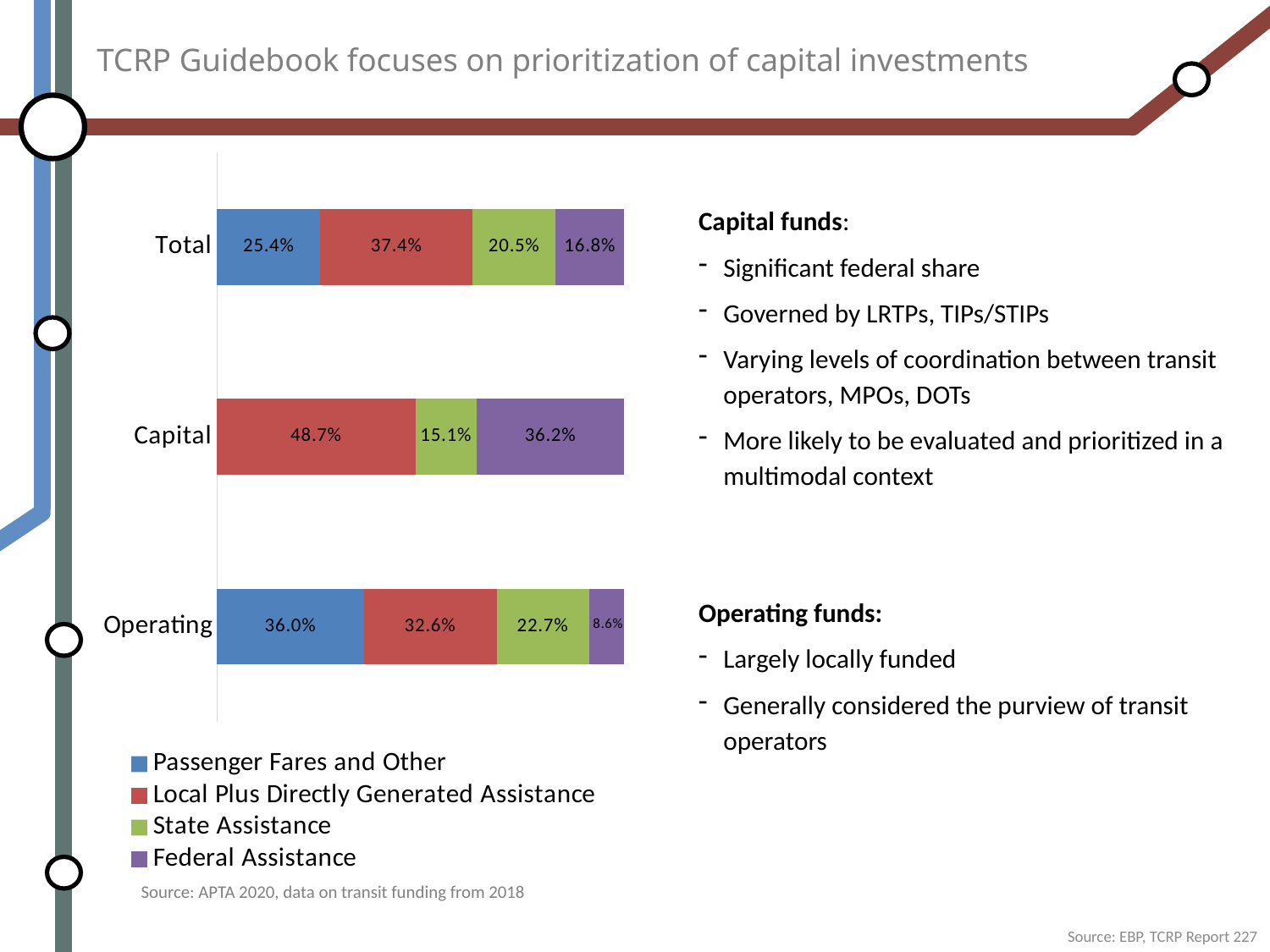
What is the Local Plus Directly Generated Assistance share for Total? 37.4% Which legend entry is shown in purple? Federal Assistance What is the difference between the Local Plus Directly Generated Assistance share for Capital and for Operating? 16.1% What is the Federal Assistance share for Capital? 36.2% Which category has the highest Federal Assistance share? Capital Which category has the lowest Federal Assistance share? Operating Which is larger: the State Assistance share for Operating or for Total? Operating How many categories are shown on the y axis? 3 How many series does the legend list? 4 What is the Passenger Fares and Other share for Operating? 36.0% What is the State Assistance share for Capital? 15.1% What kind of chart is shown on the slide? Stacked bar chart